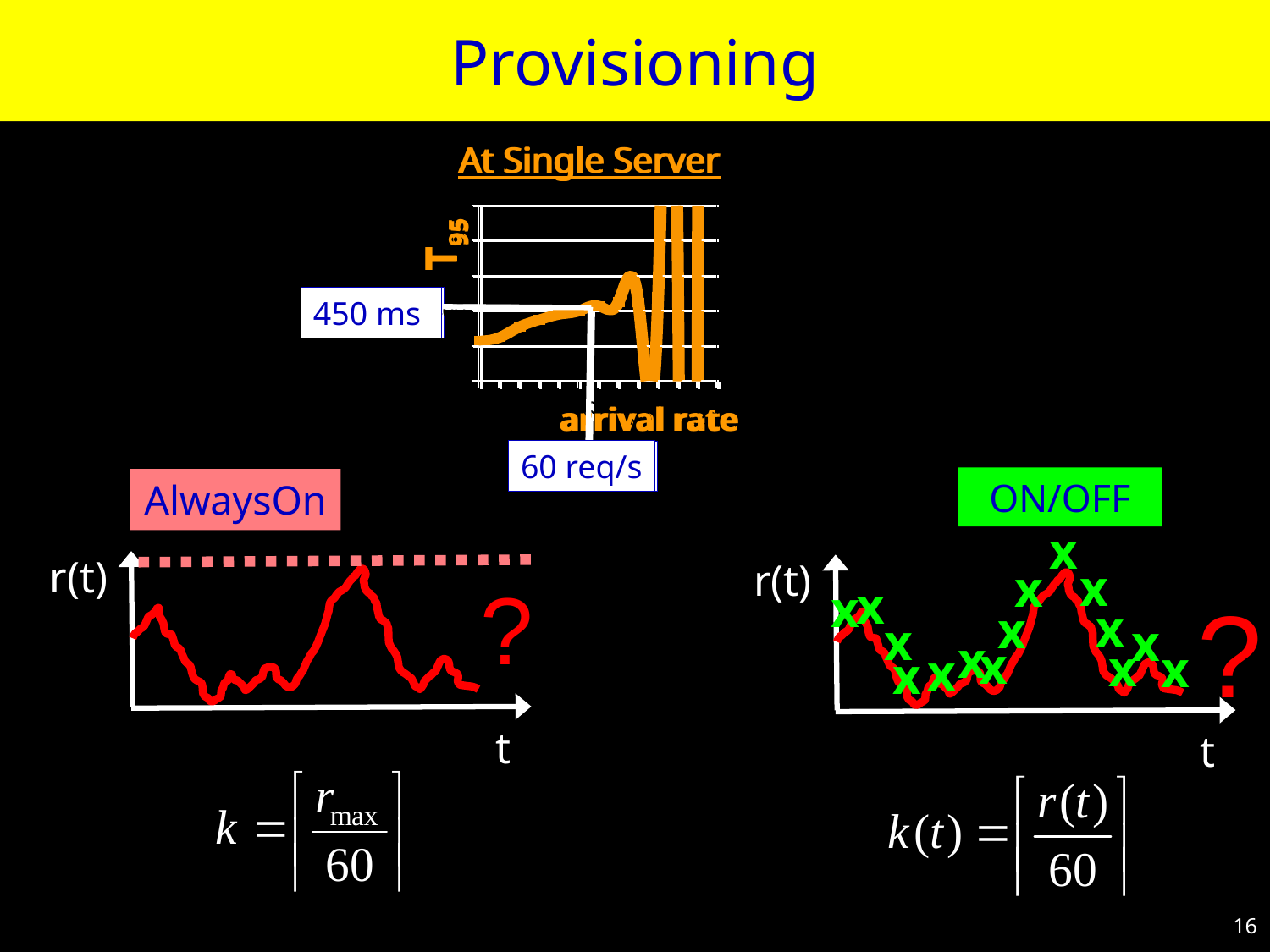
What is the y-axis label of the 'At Single Server' chart? T95 What kind of chart is the 'At Single Server' chart? line chart On the 'At Single Server' chart, what T95 value is marked at an arrival rate of 60 req/s? 450 ms On the 'At Single Server' chart, what arrival rate is marked where T95 reaches 450 ms? 60 req/s On the 'At Single Server' chart, does T95 rise or fall as the arrival rate increases up to the marked 60 req/s point? rises What is the x-axis label of the 'At Single Server' chart? arrival rate How many lines are plotted on the 'At Single Server' chart? 1